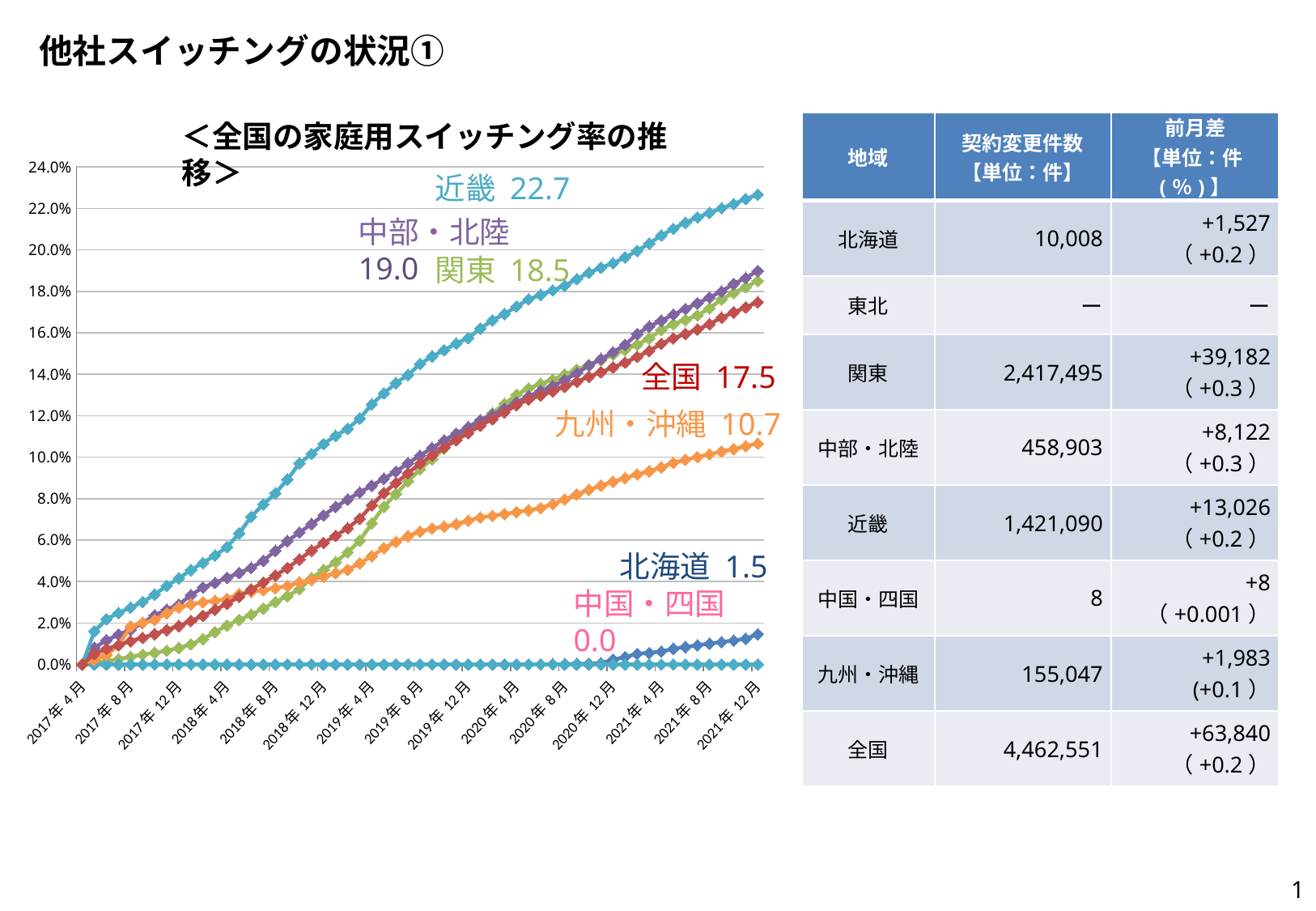
Do the switching rates on the line chart generally rise or fall over time? rise What is the final value shown for 北海道 on the line chart? 1.5 Which has the higher final value on the line chart, 中部・北陸 or 関東? 中部・北陸 What is the final value shown for 九州・沖縄 on the line chart? 10.7 What is the title of the line chart? ＜全国の家庭用スイッチング率の推移＞ What is the final value shown for 関東 on the line chart? 18.5 Which region has the lowest switching rate at the end of the line chart? 中国・四国 What kind of chart is shown on the slide? line chart Which region has the highest switching rate at the end of the line chart? 近畿 What is the final value shown for 近畿 on the line chart? 22.7 Is the value for 九州・沖縄 at 2020年4月 greater or less than 6.0%? greater What is the difference between the final values for 近畿 and 関東 on the line chart? 4.2